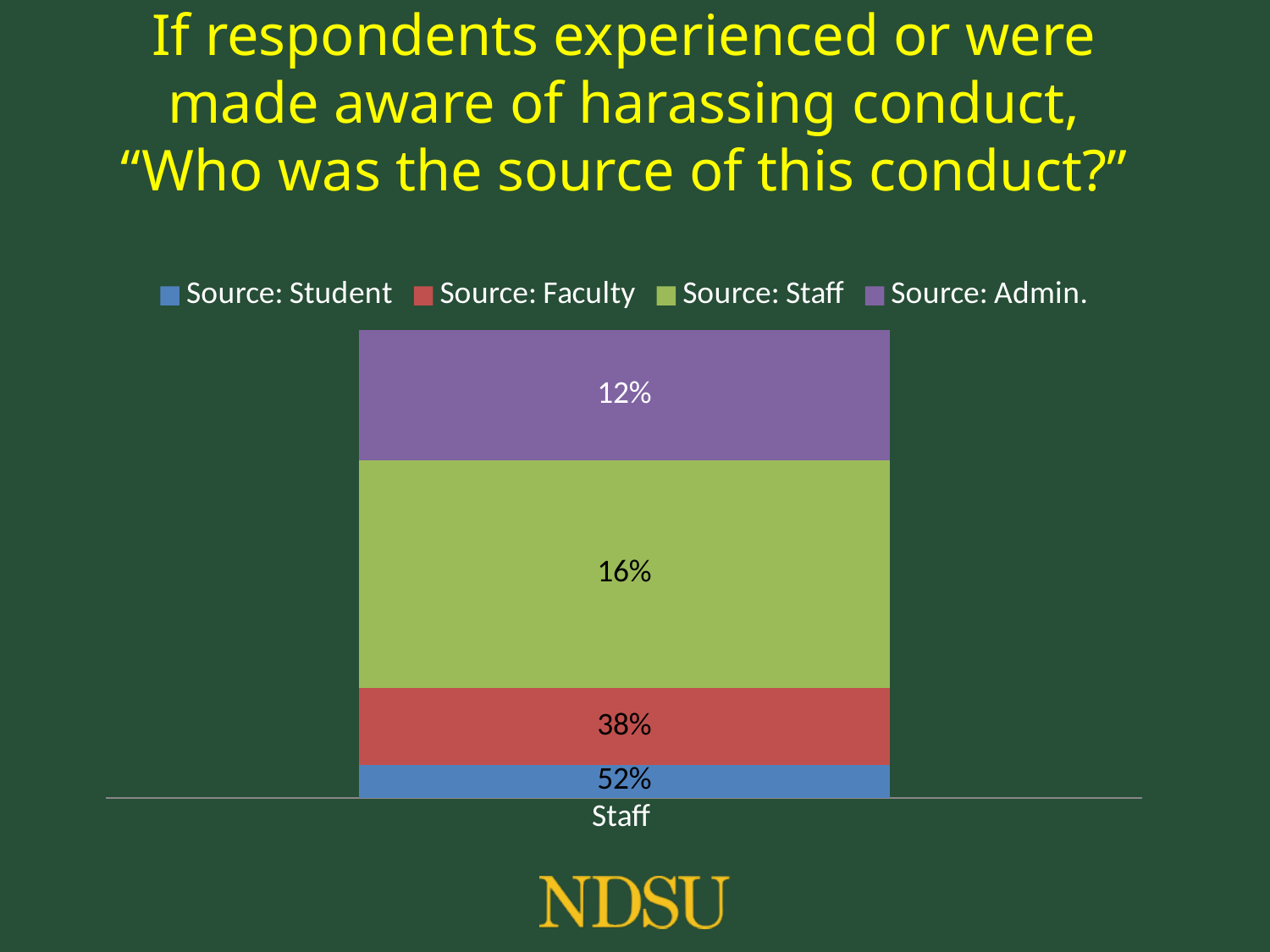
Which is larger, the value for Source: Staff or the value for Source: Admin.? Source: Staff What percentage is shown for Source: Faculty? 38% What kind of chart is shown on the slide? Stacked bar chart What percentage is shown for Source: Admin.? 12% How many series does the legend list? 4 What is the difference in percentage points between Source: Student and Source: Faculty? 14 percentage points Which source has the highest labelled percentage? Source: Student Which source has the lowest labelled percentage? Source: Admin. What percentage is shown for Source: Student? 52% What percentage is shown for Source: Staff? 16% What is the difference in percentage points between Source: Faculty and Source: Staff? 22 percentage points What is the category label shown on the x axis? Staff